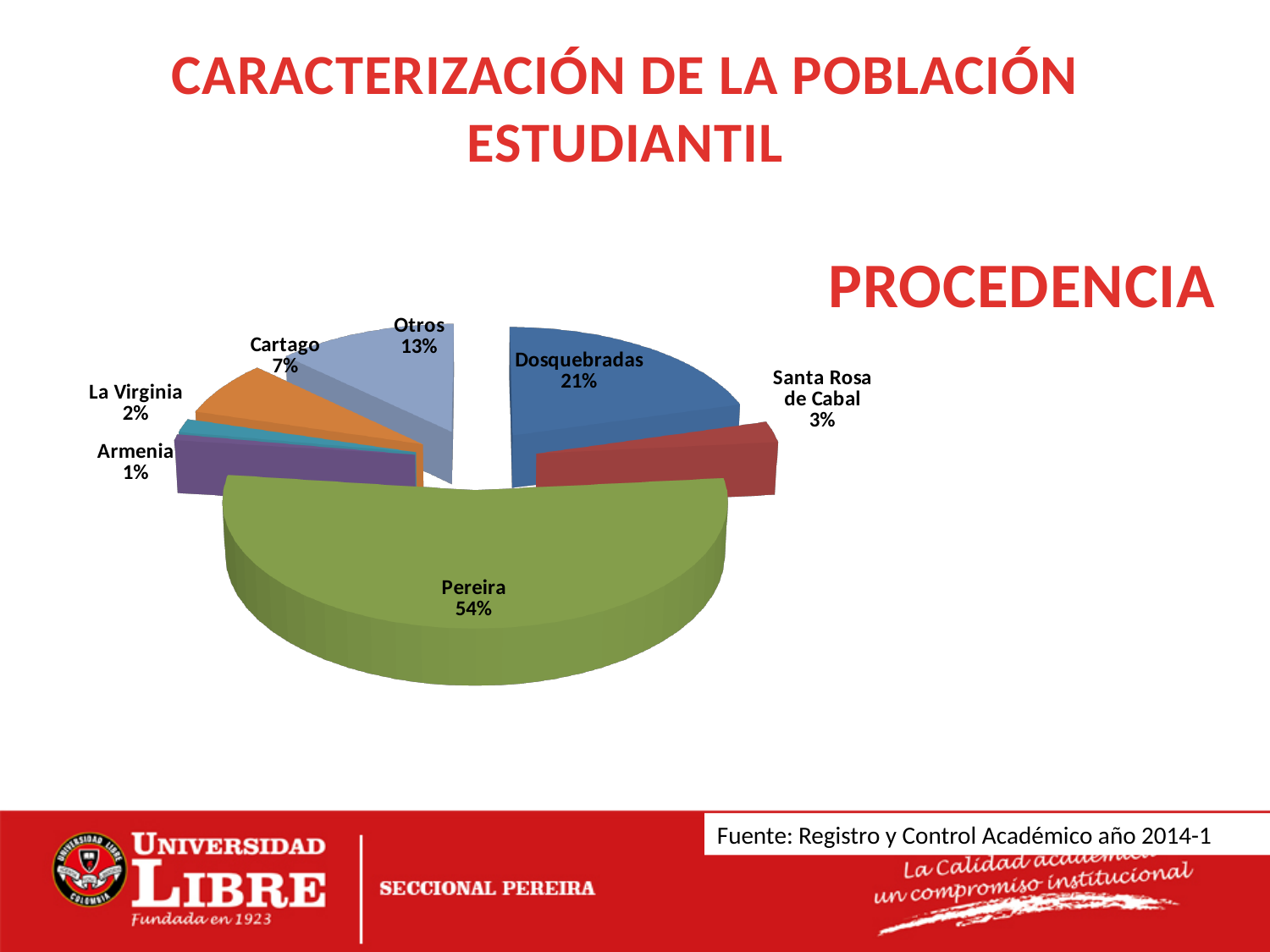
What kind of chart is shown on the slide? Pie chart How many categories are shown in the pie chart? 7 What is the value shown for Santa Rosa de Cabal? 3% What is the difference between the shares of Otros and Cartago? 6% What is the value shown for Dosquebradas? 21% What is the title of the chart? PROCEDENCIA What is the difference between the shares of Pereira and Dosquebradas? 33% What is the value shown for Otros? 13% What share of the pie does Pereira represent? 54% Which category has the largest slice of the pie? Pereira Which is larger, the share for Cartago or the share for La Virginia? Cartago Which category has the smallest slice of the pie? Armenia